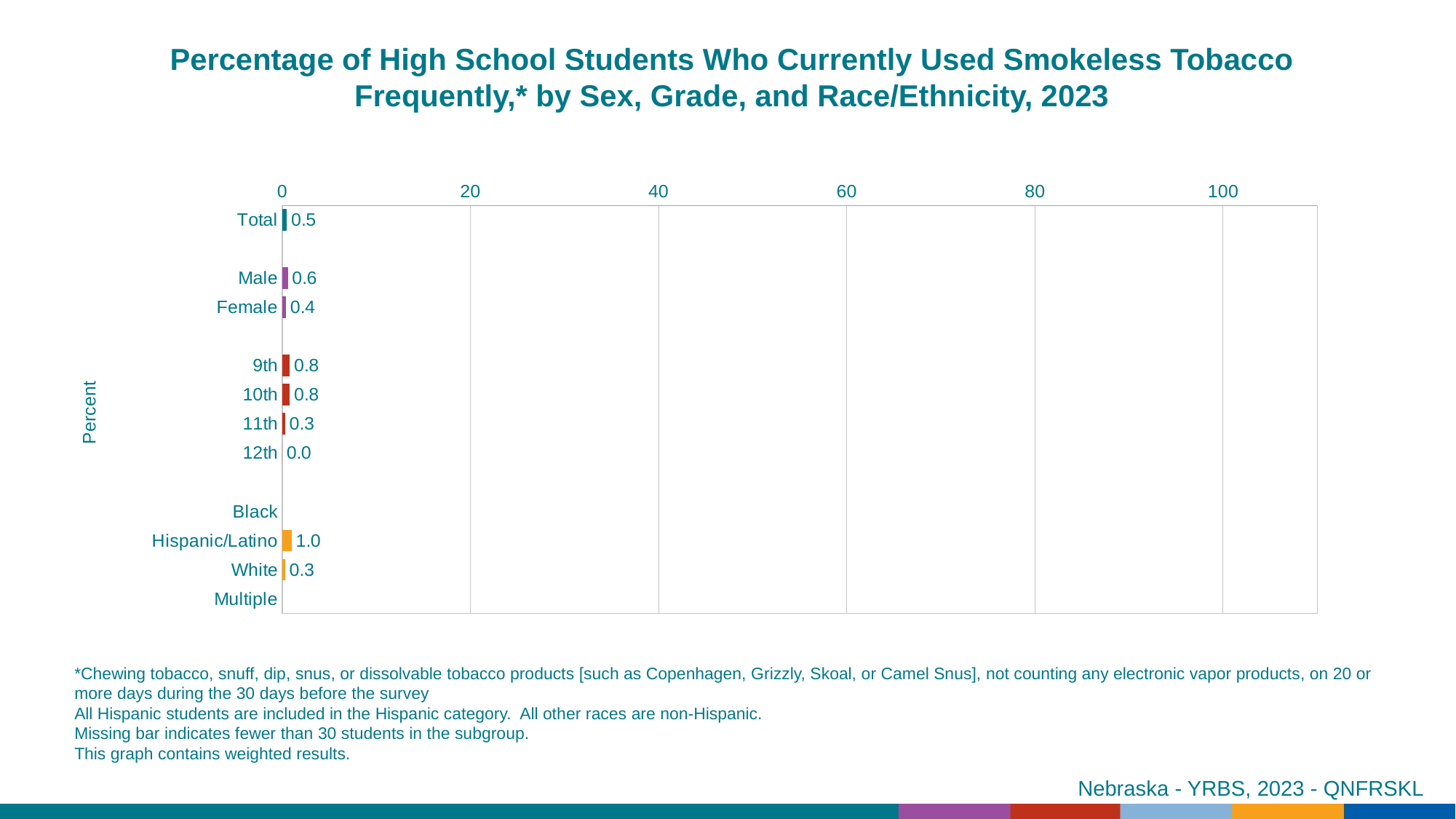
What is the difference between the values for Hispanic/Latino and White? 0.7 How many categories are listed on the vertical axis? 12 Which is larger, the value for 9th grade or the value for 11th grade? 9th What is the value for Total? 0.5 Which category with a printed value has the highest value? Hispanic/Latino What kind of chart is shown on the slide? bar chart What is the value for Male? 0.6 What is the difference between the values for Male and Female? 0.2 What is the value for 12th grade? 0.0 Which two race/ethnicity categories have no bar shown? Black and Multiple What is the value for Hispanic/Latino? 1.0 Is the value for Total greater or less than 20? less